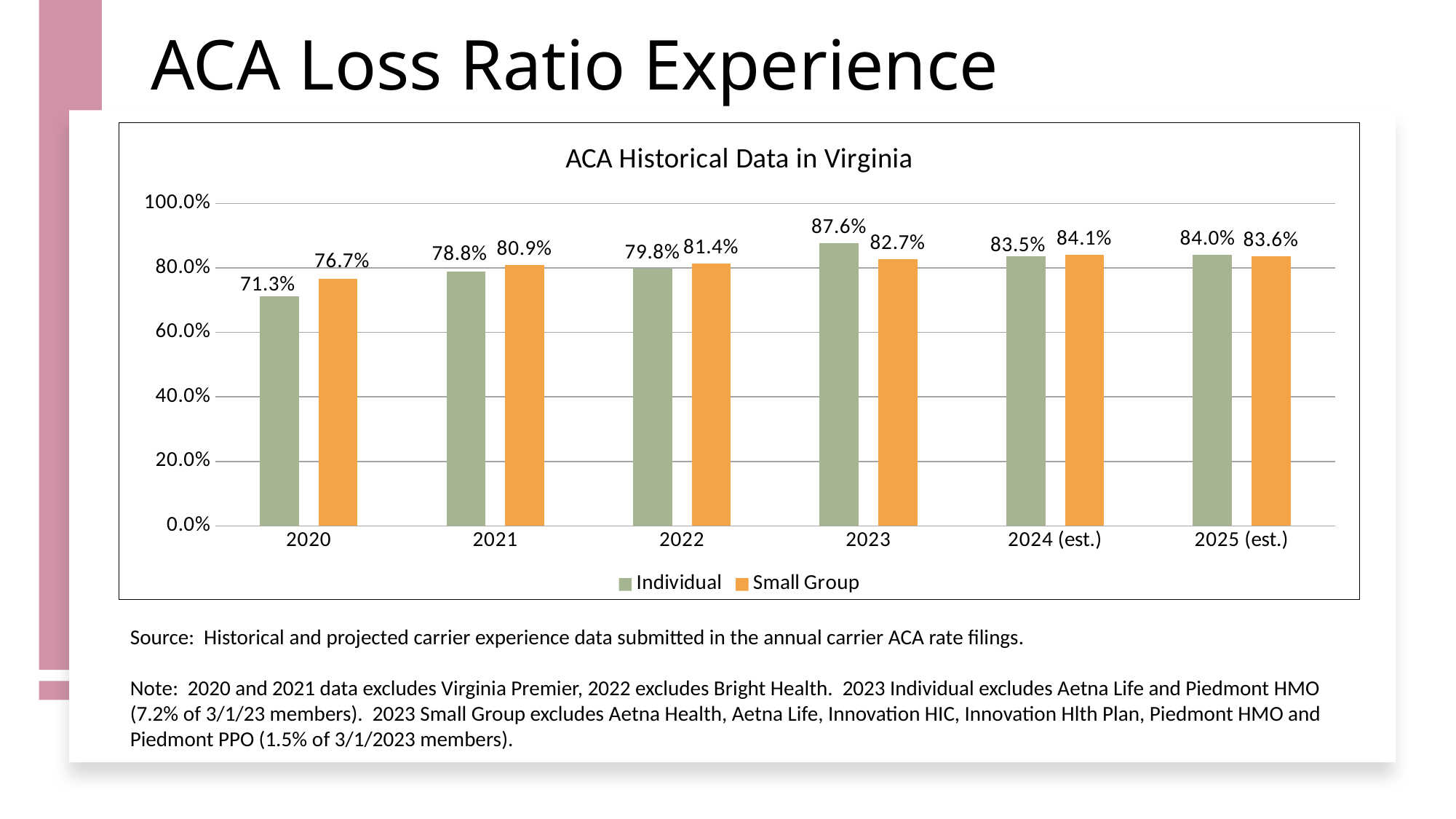
What kind of chart is shown on the slide? bar chart What is the Individual loss ratio for 2025 (est.)? 84.0% What is the Small Group loss ratio for 2023? 82.7% In 2023, which series has the larger loss ratio, Individual or Small Group? Individual What is the Individual loss ratio for 2020? 71.3% How many series does the legend list? 2 What is the title of the chart? ACA Historical Data in Virginia Which year has the highest Individual loss ratio? 2023 Is the Individual loss ratio for 2021 greater or less than 80.0%? less Which year has the lowest Small Group loss ratio? 2020 What is the difference between the Individual and Small Group loss ratios in 2020? 5.4% How many years are shown on the x axis? 6